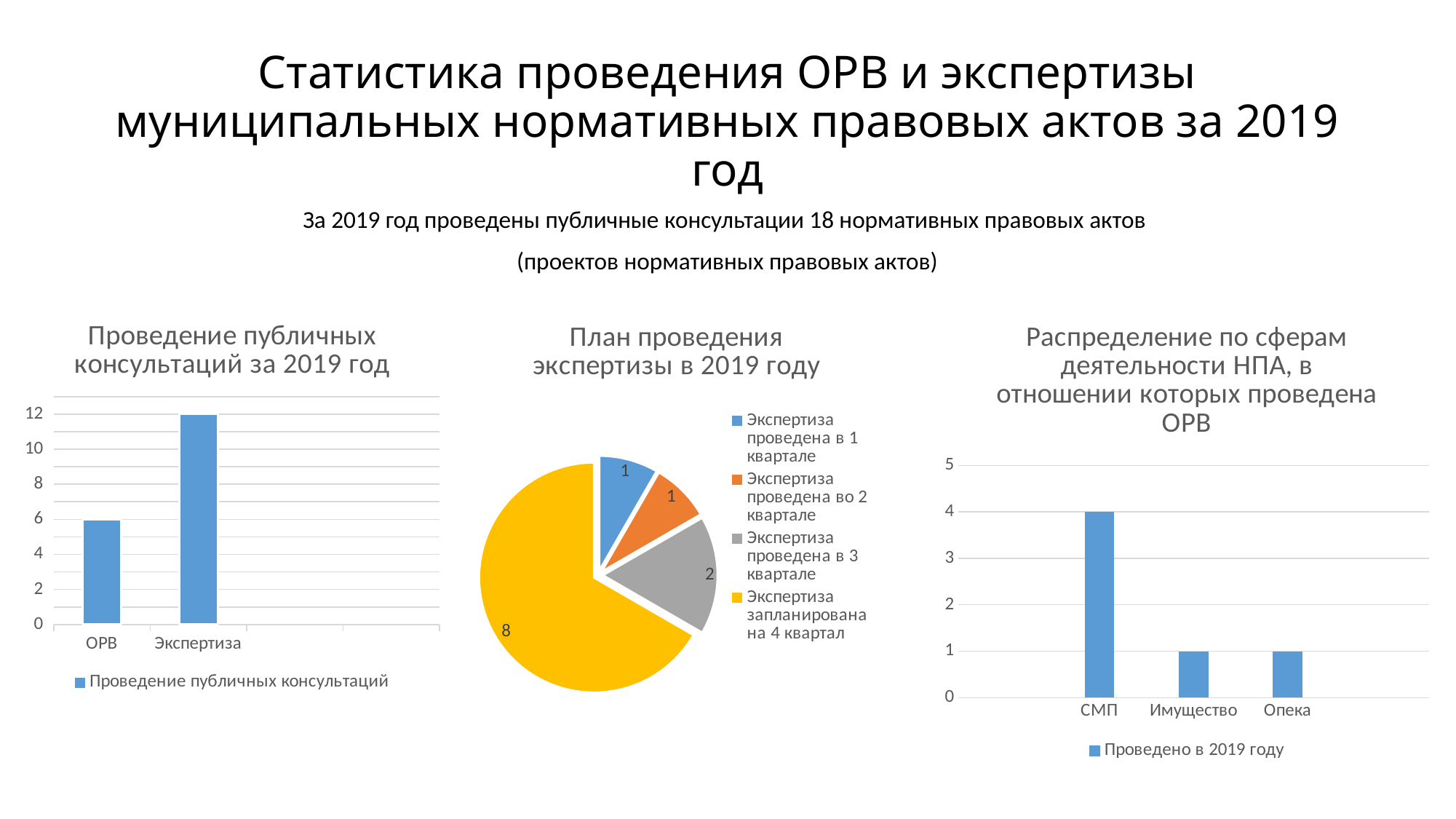
In the pie chart 'План проведения экспертизы в 2019 году', how many slices are there? 4 In the pie chart 'План проведения экспертизы в 2019 году', which slice is the largest? Экспертиза запланирована на 4 квартал In the chart 'Распределение по сферам деятельности НПА, в отношении которых проведена ОРВ', how many categories are shown on the x axis? 3 In the chart 'Проведение публичных консультаций за 2019 год', which category has the higher value? Экспертиза What kind of chart is 'План проведения экспертизы в 2019 году'? Pie chart In the chart 'Проведение публичных консультаций за 2019 год', what is the value for ОРВ? 6 In the pie chart 'План проведения экспертизы в 2019 году', what is the value for 'Экспертиза проведена в 3 квартале'? 2 In the pie chart 'План проведения экспертизы в 2019 году', what is the value for 'Экспертиза запланирована на 4 квартал'? 8 In the chart 'Проведение публичных консультаций за 2019 год', what is the value for Экспертиза? 12 In the chart 'Распределение по сферам деятельности НПА, в отношении которых проведена ОРВ', what is the difference between СМП and Опека? 3 In the chart 'Проведение публичных консультаций за 2019 год', what is the difference between Экспертиза and ОРВ? 6 In the chart 'Распределение по сферам деятельности НПА, в отношении которых проведена ОРВ', what is the value for СМП? 4